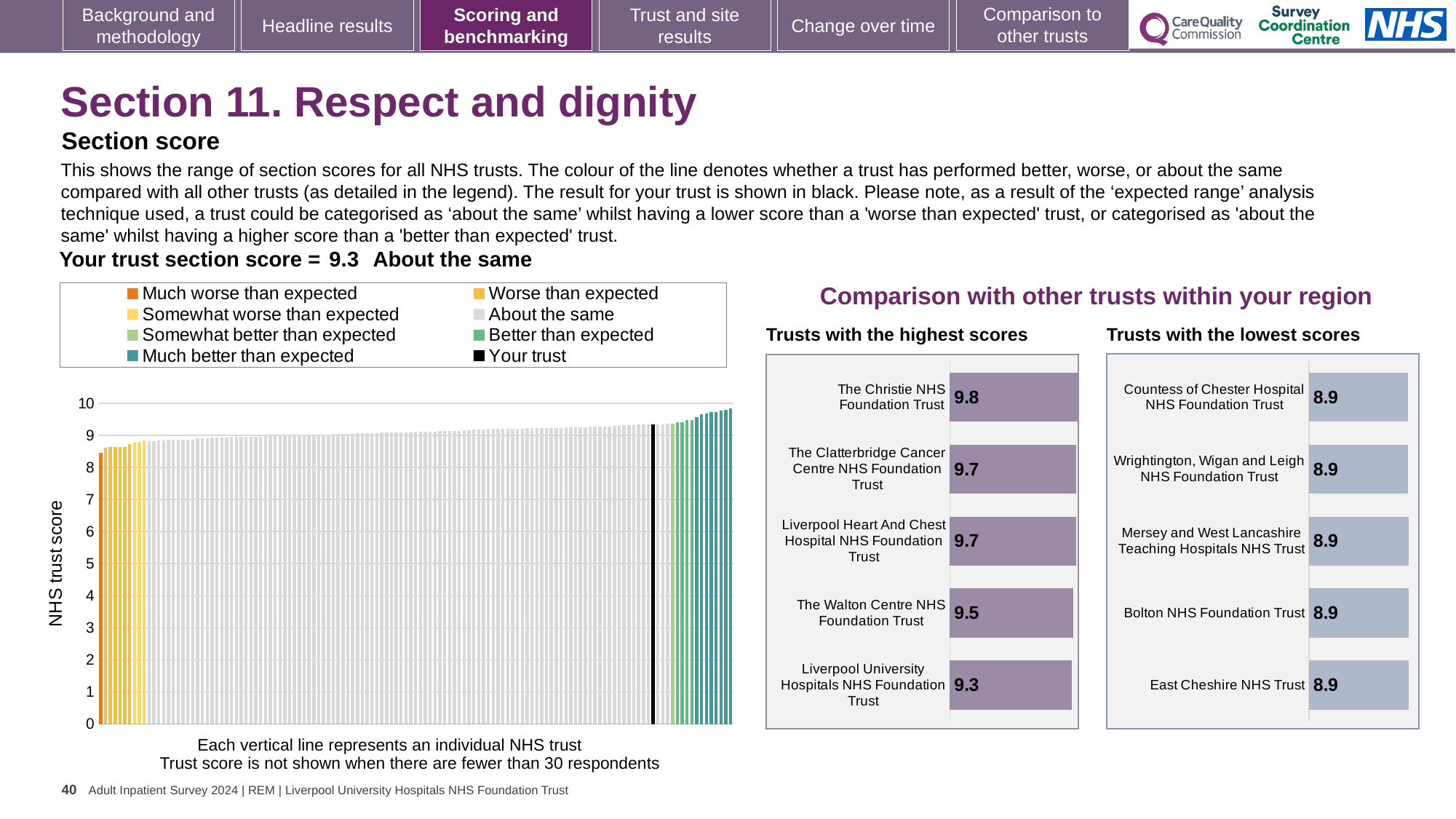
In the 'Trusts with the highest scores' chart, what is the difference between the scores of The Christie NHS Foundation Trust and Liverpool University Hospitals NHS Foundation Trust? 0.5 In the large chart on the left, do the NHS trust scores rise or fall from left to right along the x axis? Rise How many trusts are shown in the 'Trusts with the lowest scores' chart? 5 In the 'Trusts with the highest scores' chart, which trust has the highest score? The Christie NHS Foundation Trust In the 'Trusts with the highest scores' chart, which has the larger score: The Christie NHS Foundation Trust or The Walton Centre NHS Foundation Trust? The Christie NHS Foundation Trust In the 'Trusts with the highest scores' chart, what is the score for The Walton Centre NHS Foundation Trust? 9.5 In the 'Trusts with the highest scores' chart, what is the score for The Christie NHS Foundation Trust? 9.8 In the 'Trusts with the highest scores' chart, which trust has the lowest score? Liverpool University Hospitals NHS Foundation Trust What kind of chart is the large chart on the left showing NHS trust scores? Bar chart In the 'Trusts with the lowest scores' chart, what is the score for Bolton NHS Foundation Trust? 8.9 In the large chart on the left, is the value of the leftmost (orange) bar greater or less than 9? less How many entries does the legend above the large chart on the left list? 8